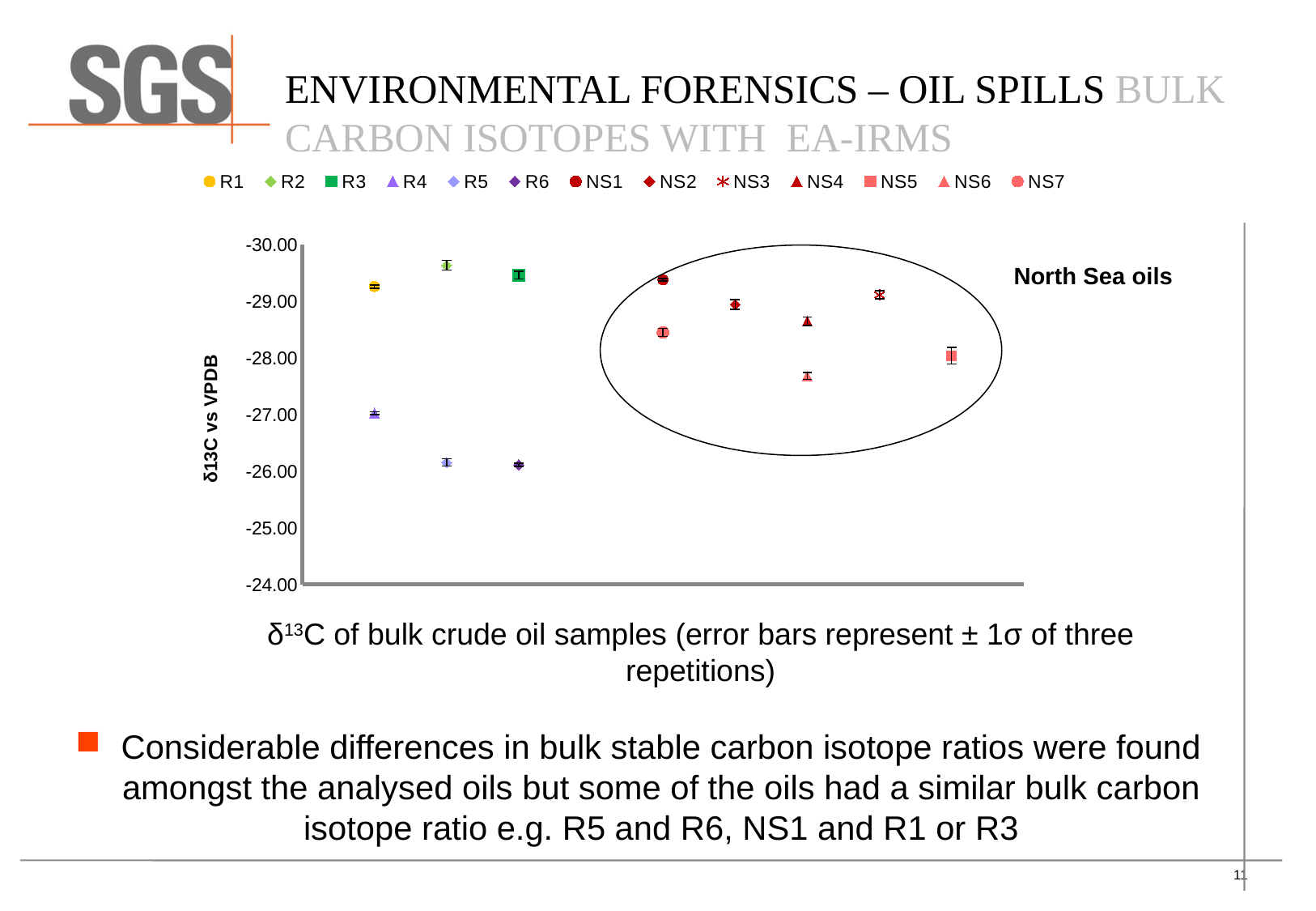
Is the δ13C value for NS4 greater or less than -28.00? less What is the label of the y axis? δ13C vs VPDB Is the δ13C value for R2 greater or less than -29.00? less Is the δ13C value for NS6 greater or less than -28.00? greater Which sample has the higher (less negative) δ13C value, NS4 or NS6? NS6 Which group of samples is circled on the chart, according to the annotation? North Sea oils What kind of chart is shown on the slide? scatter chart How many series does the chart legend list? 13 How many oil samples are plotted on the chart? 13 Which sample has the higher (less negative) δ13C value, R4 or R5? R5